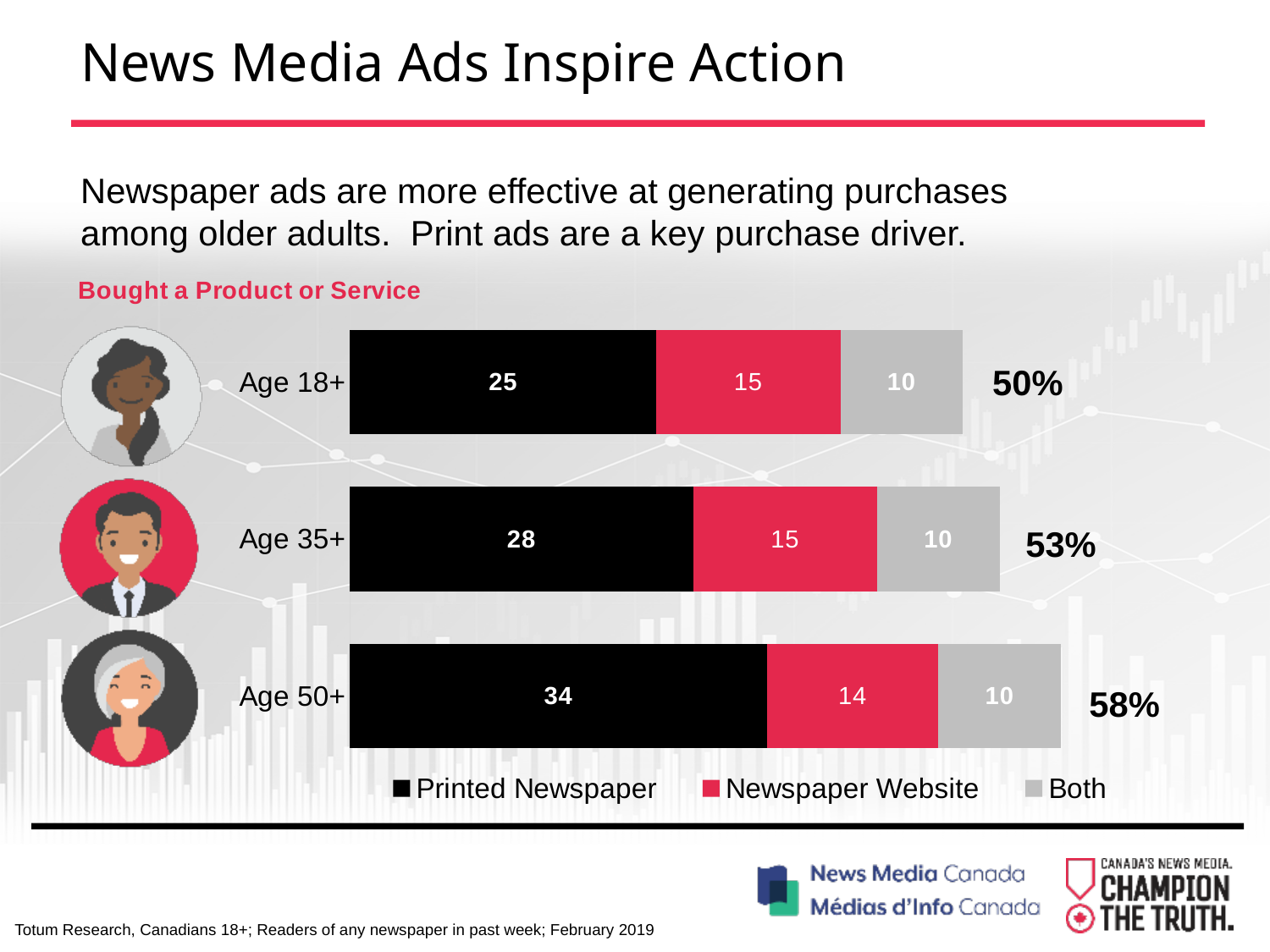
Which age group has the lowest Printed Newspaper value? Age 18+ What is the total shown for the Age 50+ bar? 58% How many series does the legend list? 3 What is the difference between the Printed Newspaper values for Age 50+ and Age 18+? 9 Which is larger for Age 35+: the Printed Newspaper value or the Newspaper Website value? Printed Newspaper What kind of chart is shown? Stacked bar chart Which age group has the highest Printed Newspaper value? Age 50+ What is the Both value for Age 35+? 10 How many age groups are shown in the chart? 3 What is the Printed Newspaper value for Age 50+? 34 What is the Newspaper Website value for Age 18+? 15 What is the title of the chart? Bought a Product or Service